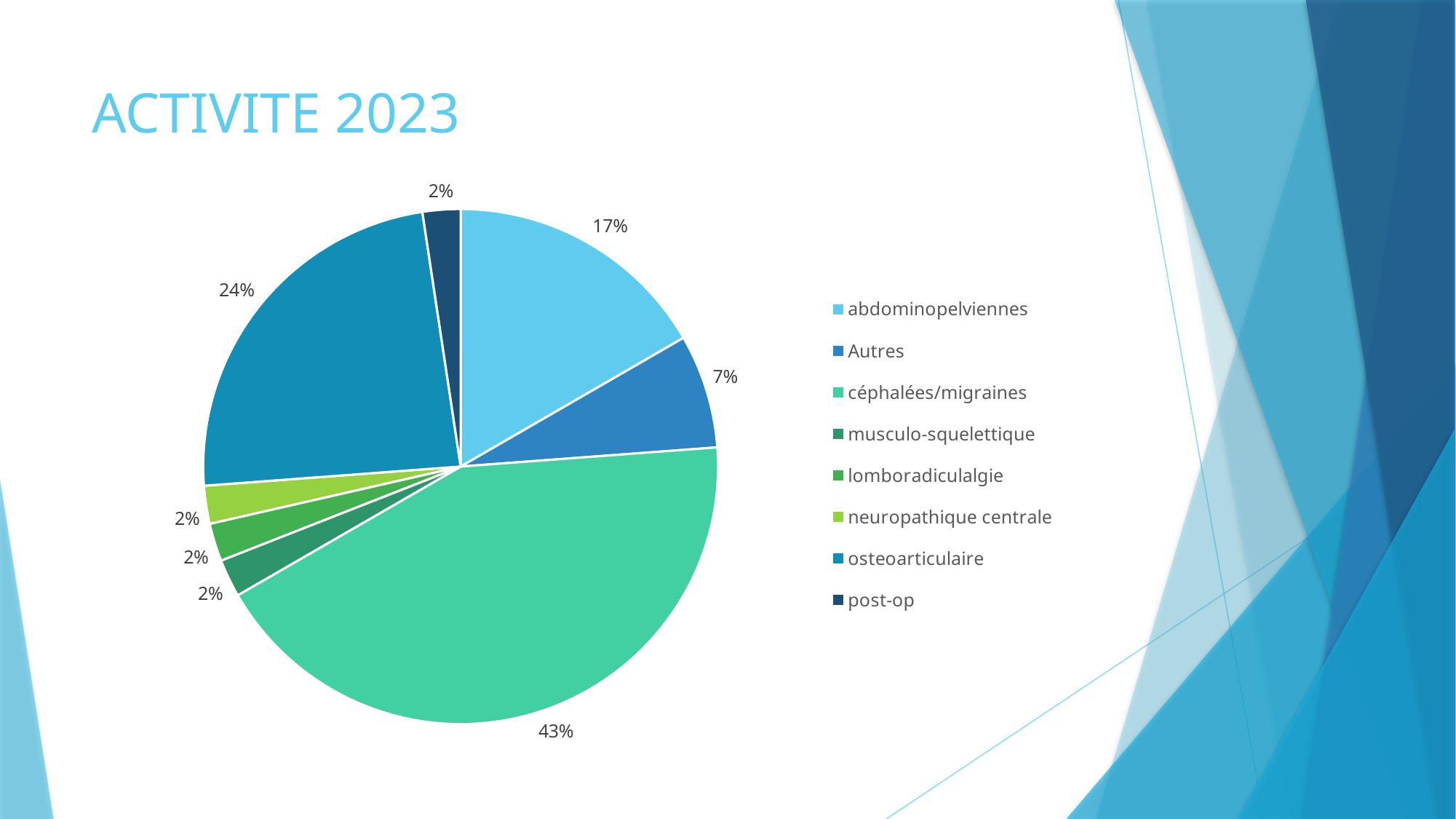
What is the value for osteoarticulaire? 24% What is the title of the slide? ACTIVITE 2023 Which is larger, the share for abdominopelviennes or the share for Autres? abdominopelviennes What type of chart is shown on the slide? pie chart What is the value for abdominopelviennes? 17% How many entries does the legend list? 8 How many categories does the pie chart have? 8 What share of the pie is céphalées/migraines? 43% What is the value for Autres? 7% What is the value for post-op? 2% Which category has the largest share of the pie? céphalées/migraines What is the difference between the shares of céphalées/migraines and osteoarticulaire? 19%